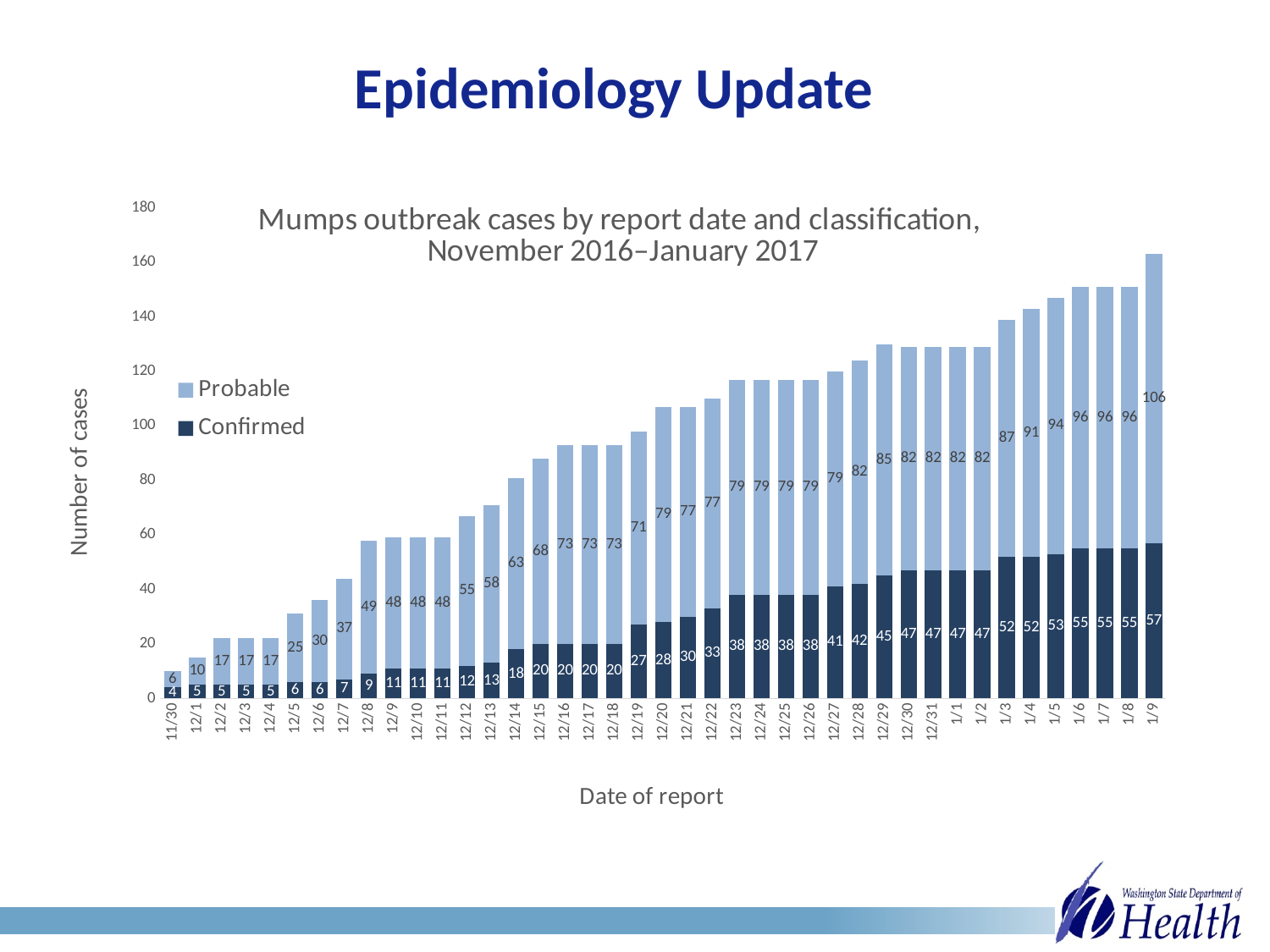
Is the total bar height for 12/29 greater or less than 120? greater Do the Confirmed values generally rise or fall from 11/30 to 1/9? Rise What is the total number of cases (Probable plus Confirmed) for 1/9? 163 What is the number of Confirmed cases reported on 1/9? 57 What is the number of Probable cases reported on 12/14? 63 What is the difference between the Probable values on 1/9 and 1/8? 10 On which report date is the Probable value highest? 1/9 How many series does the legend list? 2 On which report date is the Confirmed value lowest? 11/30 What kind of chart is shown on the slide? Stacked bar chart Which has the larger Confirmed value, 12/18 or 12/19? 12/19 How many report dates are shown on the x axis? 41